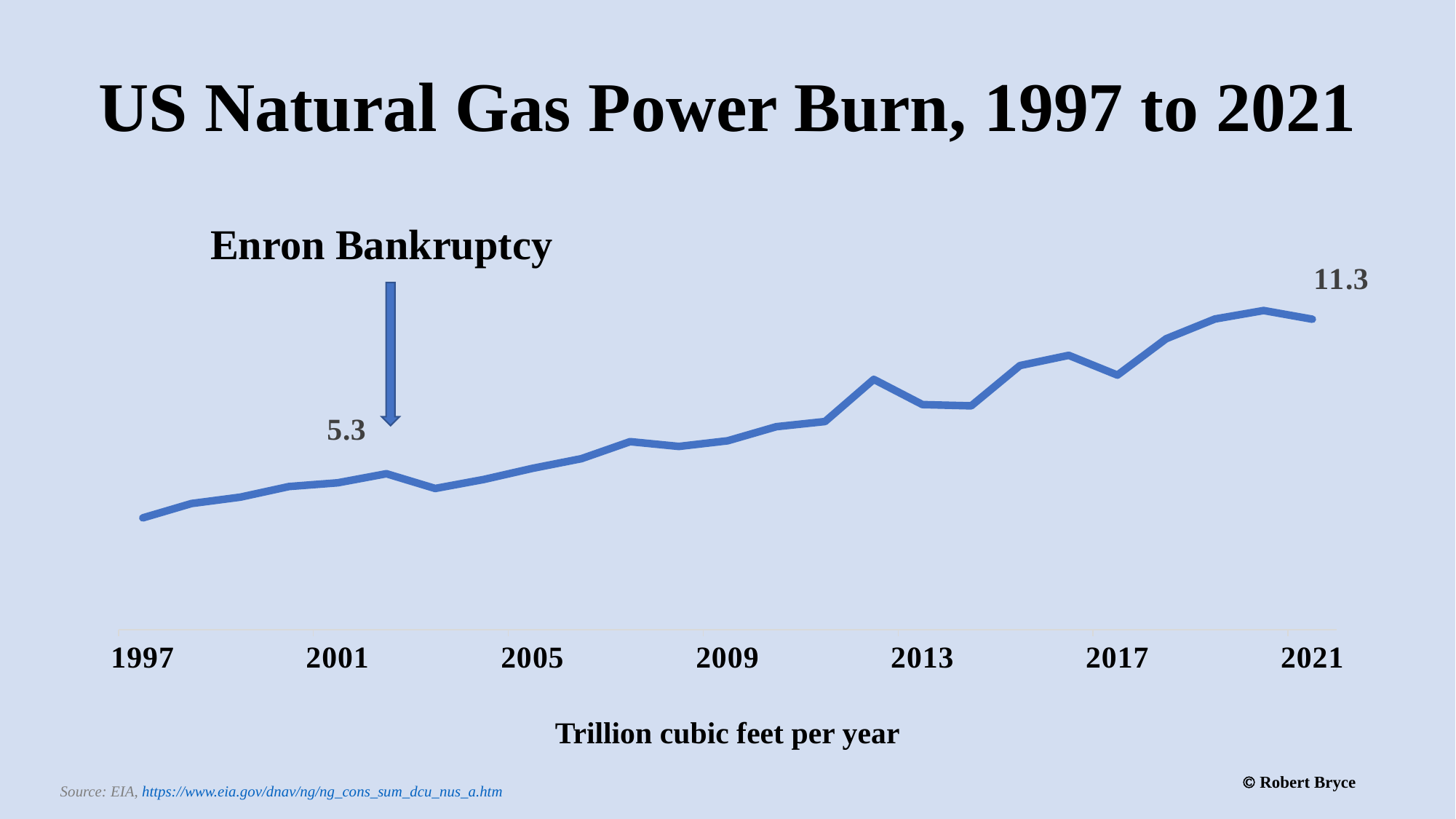
What is the title of the chart? US Natural Gas Power Burn, 1997 to 2021 What event is annotated with an arrow on the chart? Enron Bankruptcy Overall, do the values rise or fall from 1997 to 2021? Rise Which year has the larger value, 2016 or 2017? 2016 What type of chart is shown on the slide? Line chart Which year has the larger value, 2012 or 2013? 2012 In what unit are the values measured, according to the label below the x axis? Trillion cubic feet per year What is the highest value labeled on the chart? 11.3 How many year labels are shown on the x axis? 7 What value is labeled on the line at the point marked by the Enron Bankruptcy arrow? 5.3 What is the difference between the 11.3 label and the 5.3 label? 6.0 Which year has the larger value, 1997 or 2021? 2021